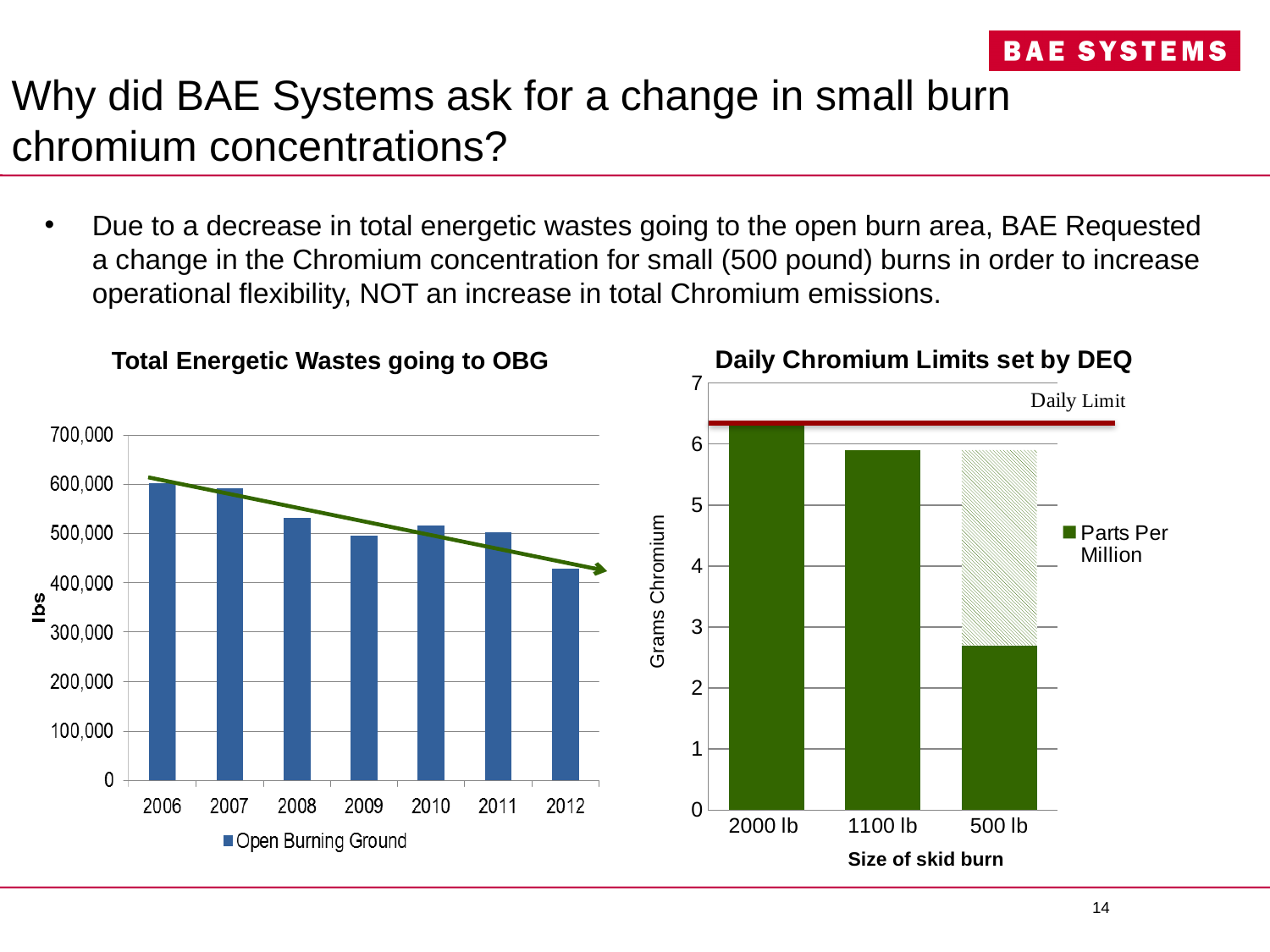
In the 'Total Energetic Wastes going to OBG' chart, how many years are shown on the x axis? 7 In the 'Total Energetic Wastes going to OBG' chart, do the values generally rise or fall from 2006 to 2012? fall In the 'Total Energetic Wastes going to OBG' chart, which year has the highest value? 2006 In the 'Daily Chromium Limits set by DEQ' chart, is the solid green bar for 500 lb greater or less than 3? less What kind of chart is the 'Total Energetic Wastes going to OBG' chart? bar chart In the 'Total Energetic Wastes going to OBG' chart, is the value for 2008 greater or less than 500,000? greater In the 'Total Energetic Wastes going to OBG' chart, which year has the lowest value? 2012 In the 'Daily Chromium Limits set by DEQ' chart, which is larger, the bar for 2000 lb or the bar for 1100 lb? 2000 lb In the 'Total Energetic Wastes going to OBG' chart, is the value for 2012 greater or less than 500,000? less In the 'Total Energetic Wastes going to OBG' chart, what is the legend entry for the bars? Open Burning Ground In the 'Daily Chromium Limits set by DEQ' chart, which skid burn size has the lowest solid green bar? 500 lb In the 'Daily Chromium Limits set by DEQ' chart, how many skid burn sizes are shown on the x axis? 3